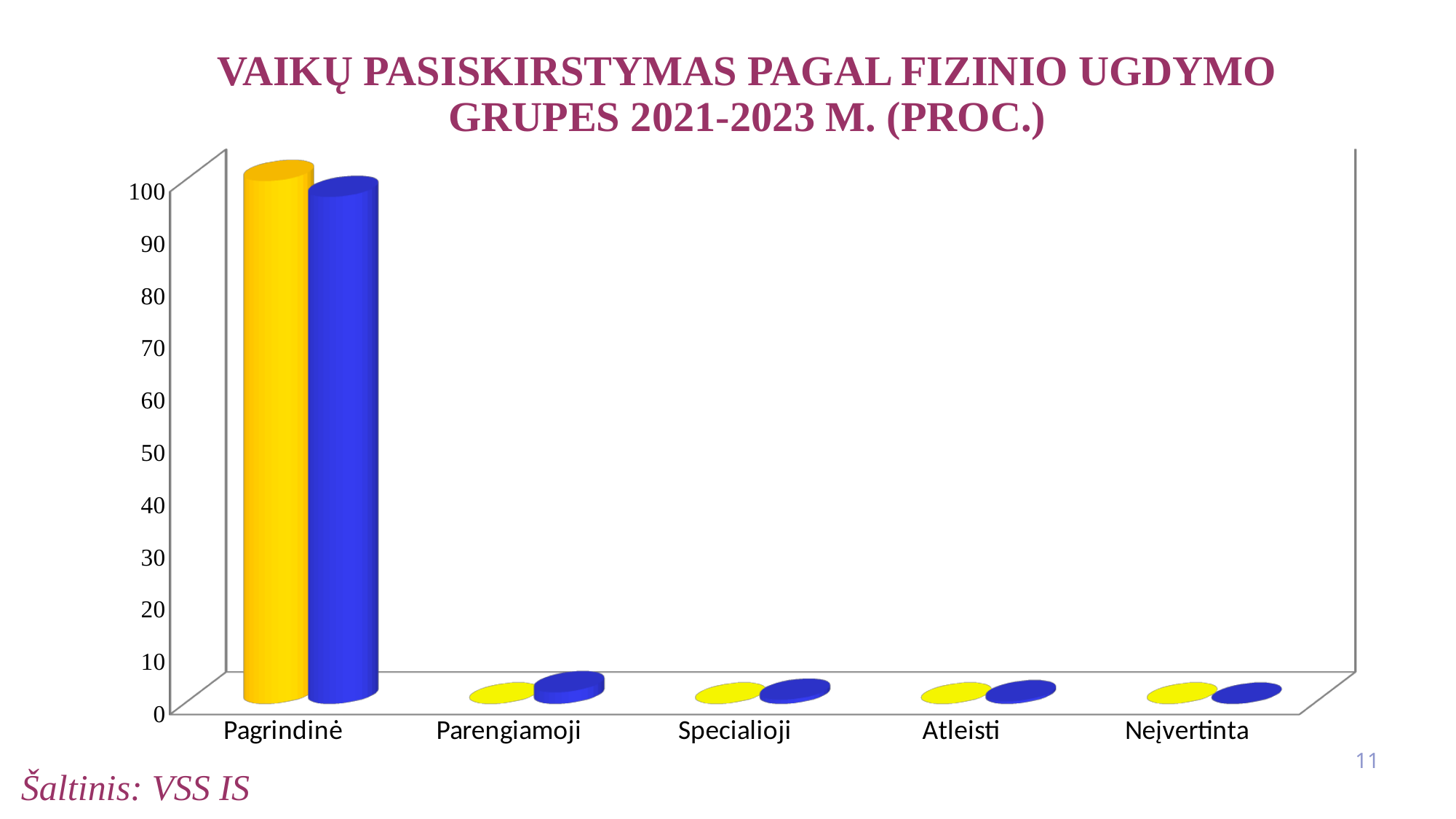
Which category has the highest bars in the chart? Pagrindinė What is the title of the chart? VAIKŲ PASISKIRSTYMAS PAGAL FIZINIO UGDYMO GRUPES 2021-2023 M. (PROC.) Is the blue bar for Specialioji greater or less than 10? less Which category has the larger yellow bar, Pagrindinė or Parengiamoji? Pagrindinė Is the blue bar for Pagrindinė greater or less than 90? greater What source is cited below the chart? VSS IS How many categories are shown on the x axis of the chart? 5 What kind of chart is shown on the slide? bar chart Is the blue bar for Neįvertinta greater or less than 10? less